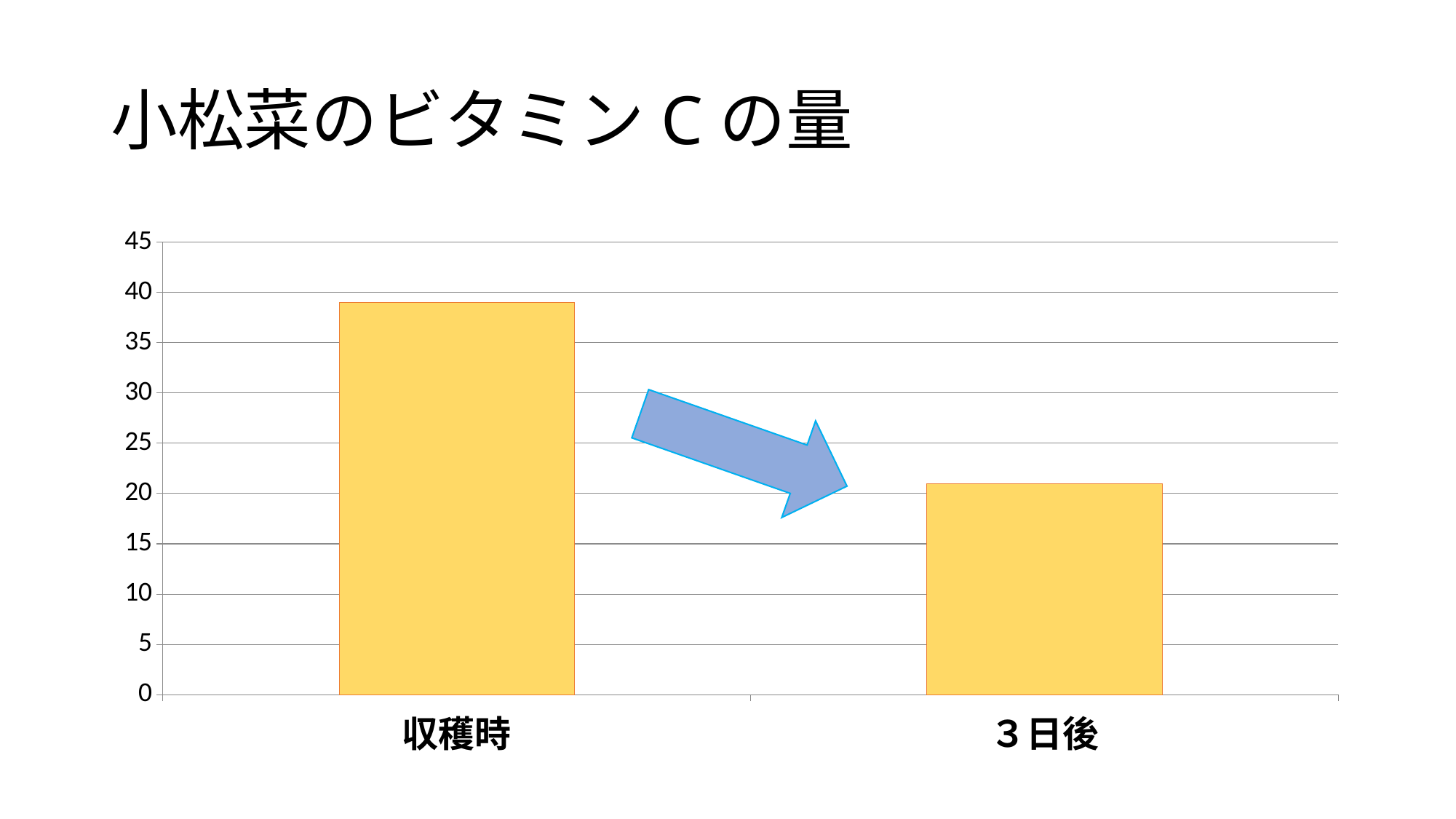
How many categories are shown on the x axis of the chart? 2 Which category has the highest value in the chart? 収穫時 What kind of chart is shown on the slide? bar chart Which category has the lowest value in the chart? ３日後 Do the values rise or fall from 収穫時 to ３日後? fall What is the highest value shown on the y axis of the chart? 45 Is the value for 収穫時 greater or less than 35? greater Is the value for ３日後 greater or less than 25? less Is the value for ３日後 greater or less than 20? greater What is the title of the slide containing the chart? 小松菜のビタミンＣの量 Which is larger, the value for 収穫時 or the value for ３日後? 収穫時